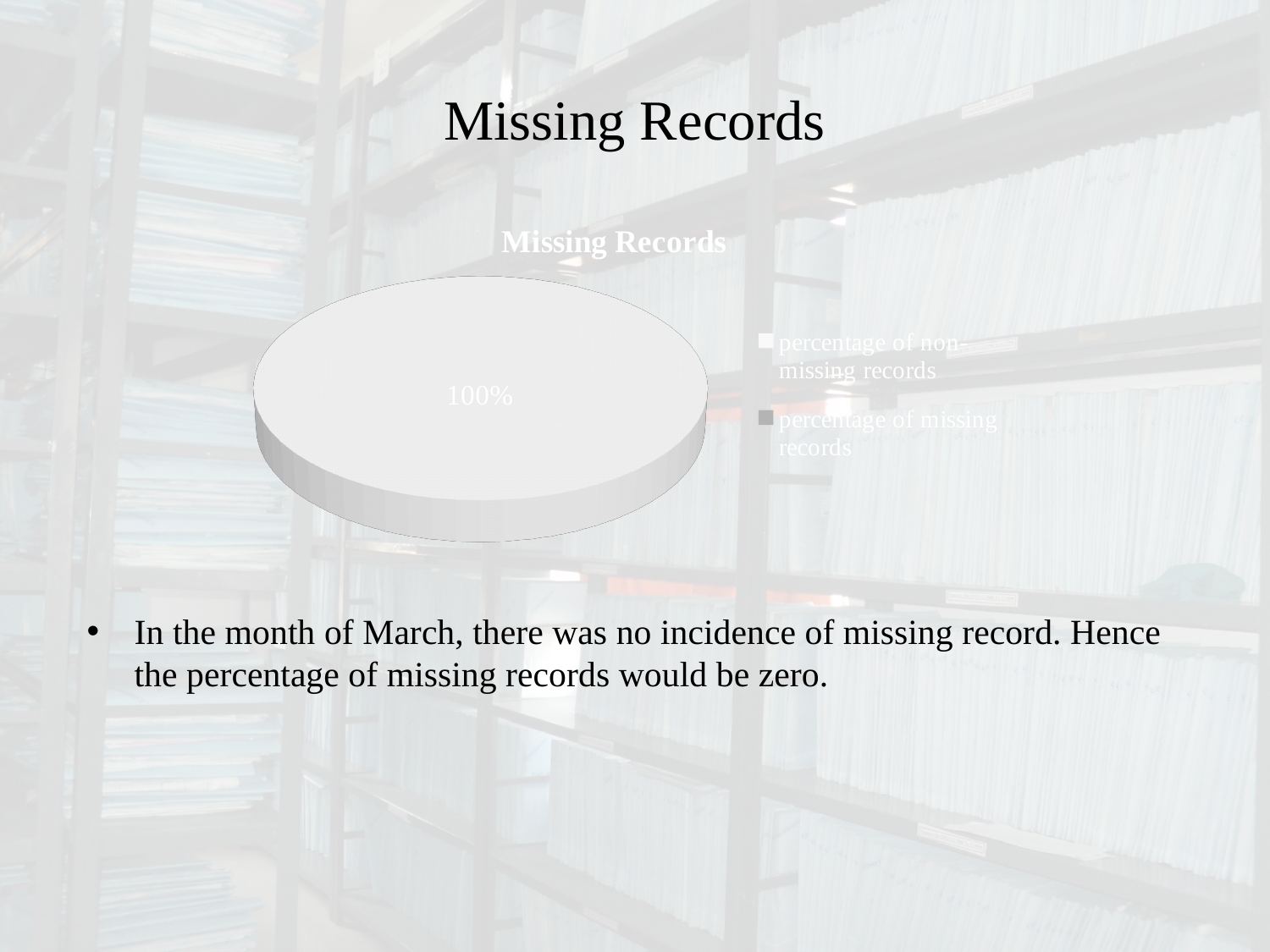
What kind of chart is shown on the slide? pie chart Which category makes up the largest share of the pie? percentage of non-missing records What share of the pie does 'percentage of non-missing records' take? 100% Which is larger in the pie chart, 'percentage of non-missing records' or 'percentage of missing records'? percentage of non-missing records What is the title of the chart? Missing Records What percentage is printed on the pie slice? 100% What is the first entry listed in the chart legend? percentage of non-missing records How many entries does the chart legend list? 2 How many slices are visible in the pie chart? 1